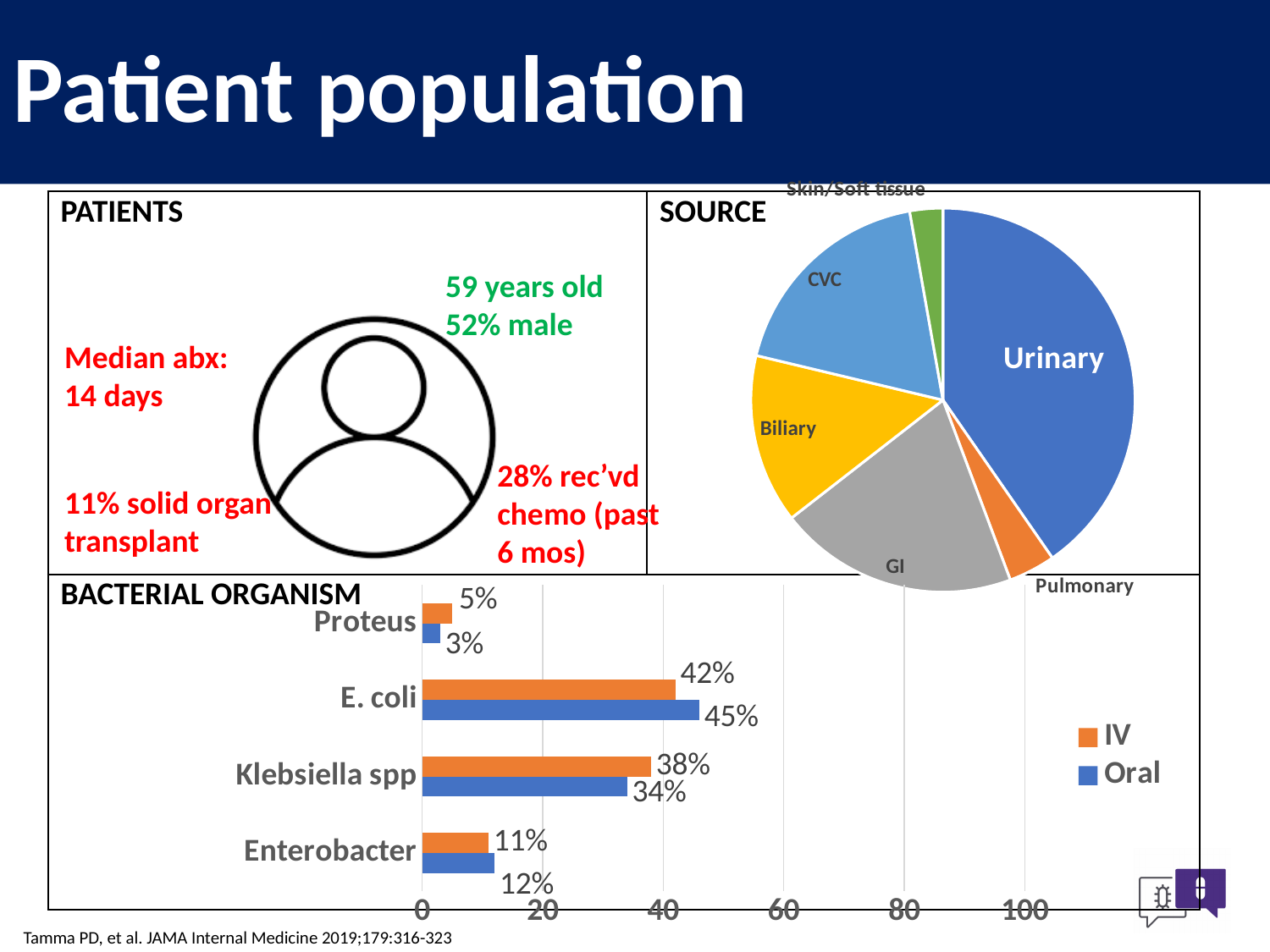
In the BACTERIAL ORGANISM bar chart, which organism has the lowest IV value? Proteus In the BACTERIAL ORGANISM bar chart, which is larger for Enterobacter, the IV value or the Oral value? Oral In the BACTERIAL ORGANISM bar chart, what is the difference between the IV and Oral values for Klebsiella spp? 4% How many series does the legend of the BACTERIAL ORGANISM chart list? 2 In the BACTERIAL ORGANISM bar chart, what is the Oral value for Klebsiella spp? 34% In the BACTERIAL ORGANISM bar chart, what is the Oral value for Proteus? 3% In the SOURCE pie chart, which source has the largest slice? Urinary In the BACTERIAL ORGANISM bar chart, which organism has the highest Oral value? E. coli In the BACTERIAL ORGANISM bar chart, what is the IV value for E. coli? 42% How many slices does the SOURCE pie chart have? 6 How many organisms are shown in the BACTERIAL ORGANISM bar chart? 4 What kind of chart is the SOURCE chart? Pie chart